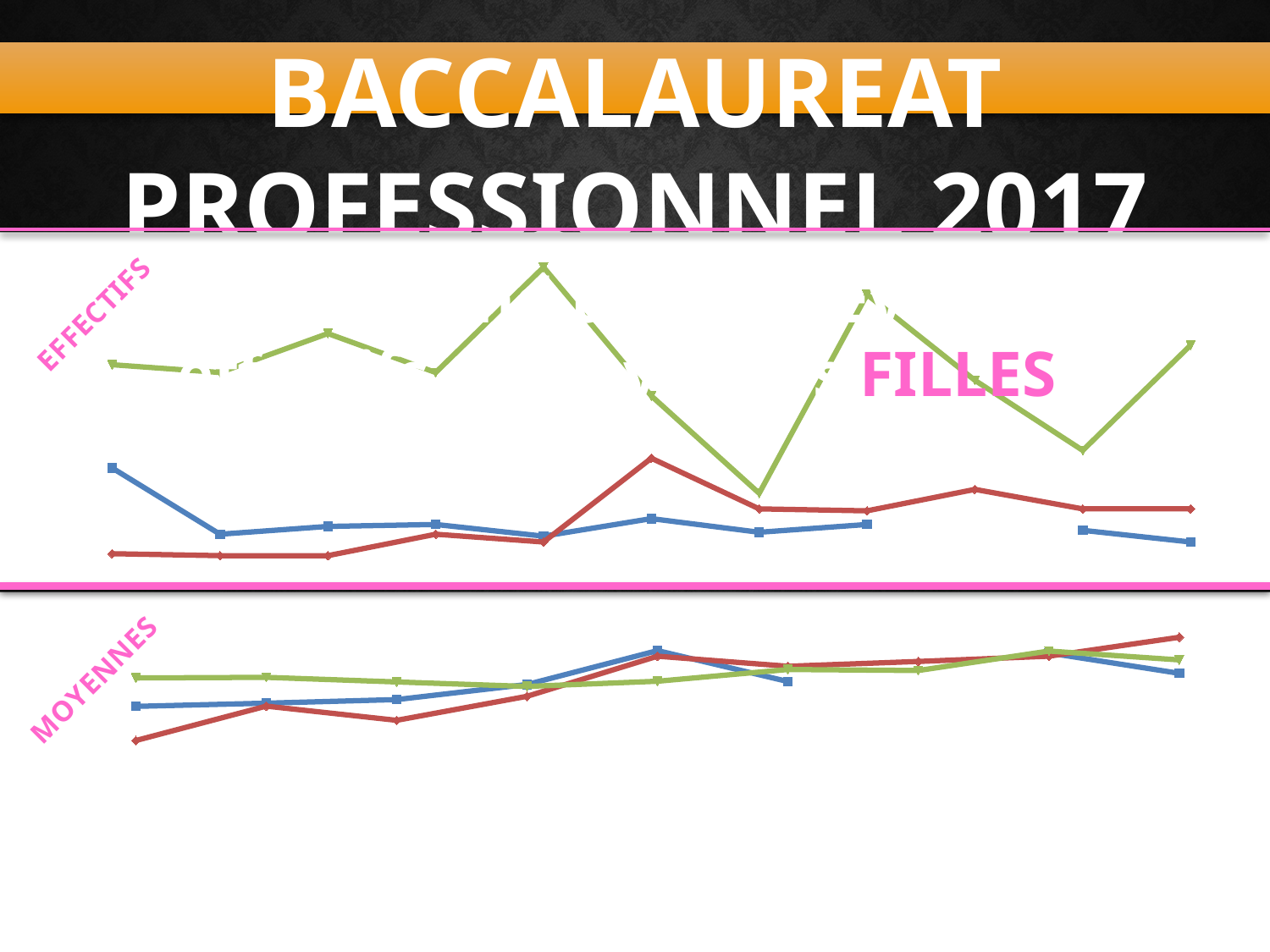
What label is written in pink next to the top chart? EFFECTIFS In the top chart (EFFECTIFS), which coloured line is the highest across the whole chart? green How many lines are plotted in the bottom chart (MOYENNES)? 3 What kind of chart is the bottom chart labelled MOYENNES? line chart In the top chart (EFFECTIFS), at the leftmost point, is the blue line or the red line higher? blue What kind of chart is the top chart labelled EFFECTIFS? line chart In the bottom chart (MOYENNES), does the red line generally rise or fall from left to right? rise In the bottom chart (MOYENNES), which coloured line is the highest at the rightmost point? red In the bottom chart (MOYENNES), which coloured line is the lowest at the leftmost point? red In the top chart (EFFECTIFS), which coloured line is the lowest at the leftmost point? red In the top chart (EFFECTIFS), at which point from the left does the green line reach its highest value? the 5th point How many lines are plotted in the top chart (EFFECTIFS)? 3